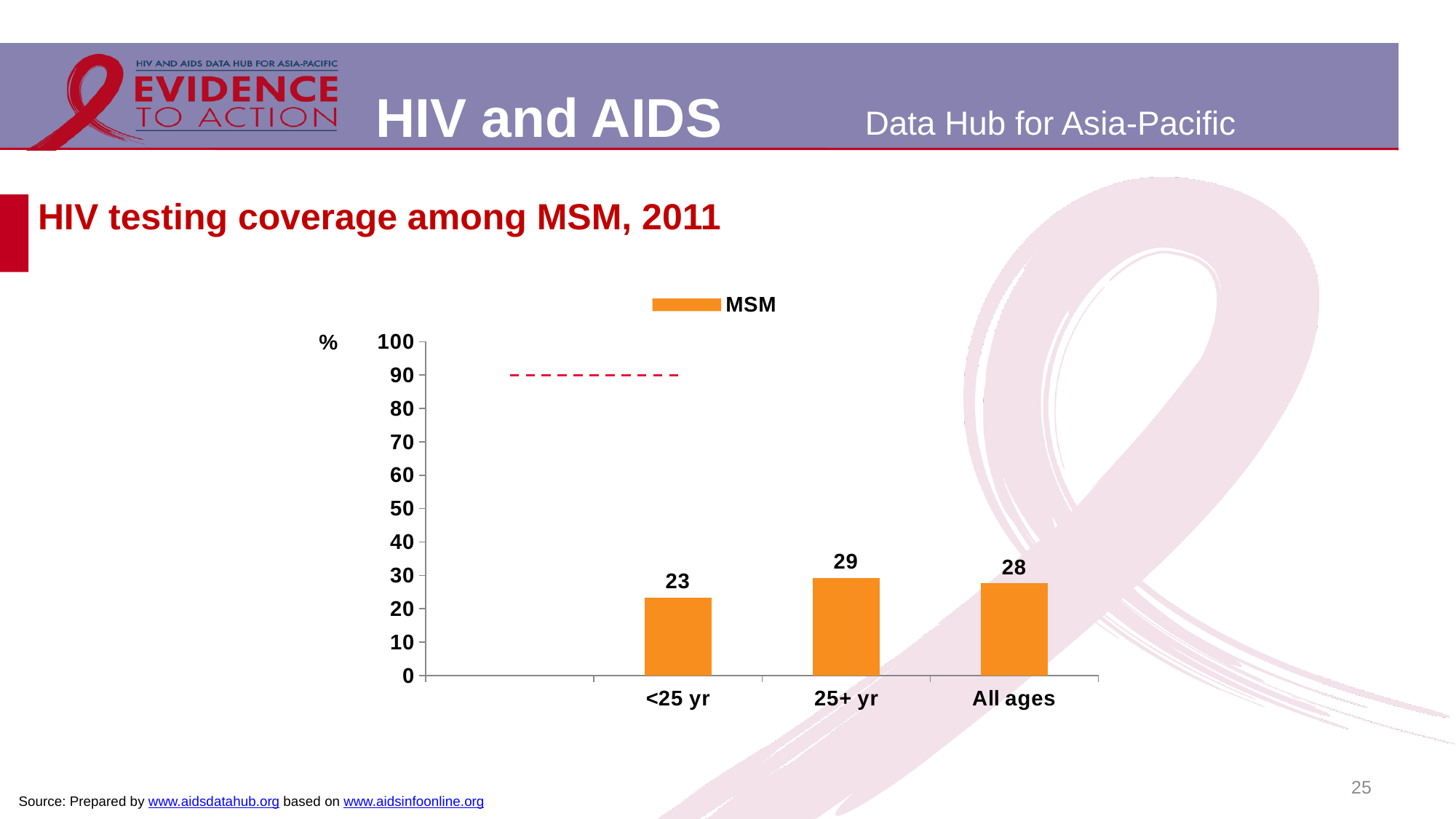
What kind of chart is shown on the slide? bar chart Which age category has the highest HIV testing coverage? 25+ yr How many age categories are shown on the x axis? 3 What is the difference between the HIV testing coverage for 25+ yr and <25 yr? 6 What is the HIV testing coverage value for MSM aged 25+ yr? 29 What is the HIV testing coverage value for MSM aged <25 yr? 23 How many series does the legend list? 1 Is the value for 25+ yr greater or less than 50? less What is the HIV testing coverage value for MSM of all ages? 28 What is the name of the series shown in the legend? MSM Which age category has the lowest HIV testing coverage? <25 yr Which is larger, the value for <25 yr or the value for All ages? All ages